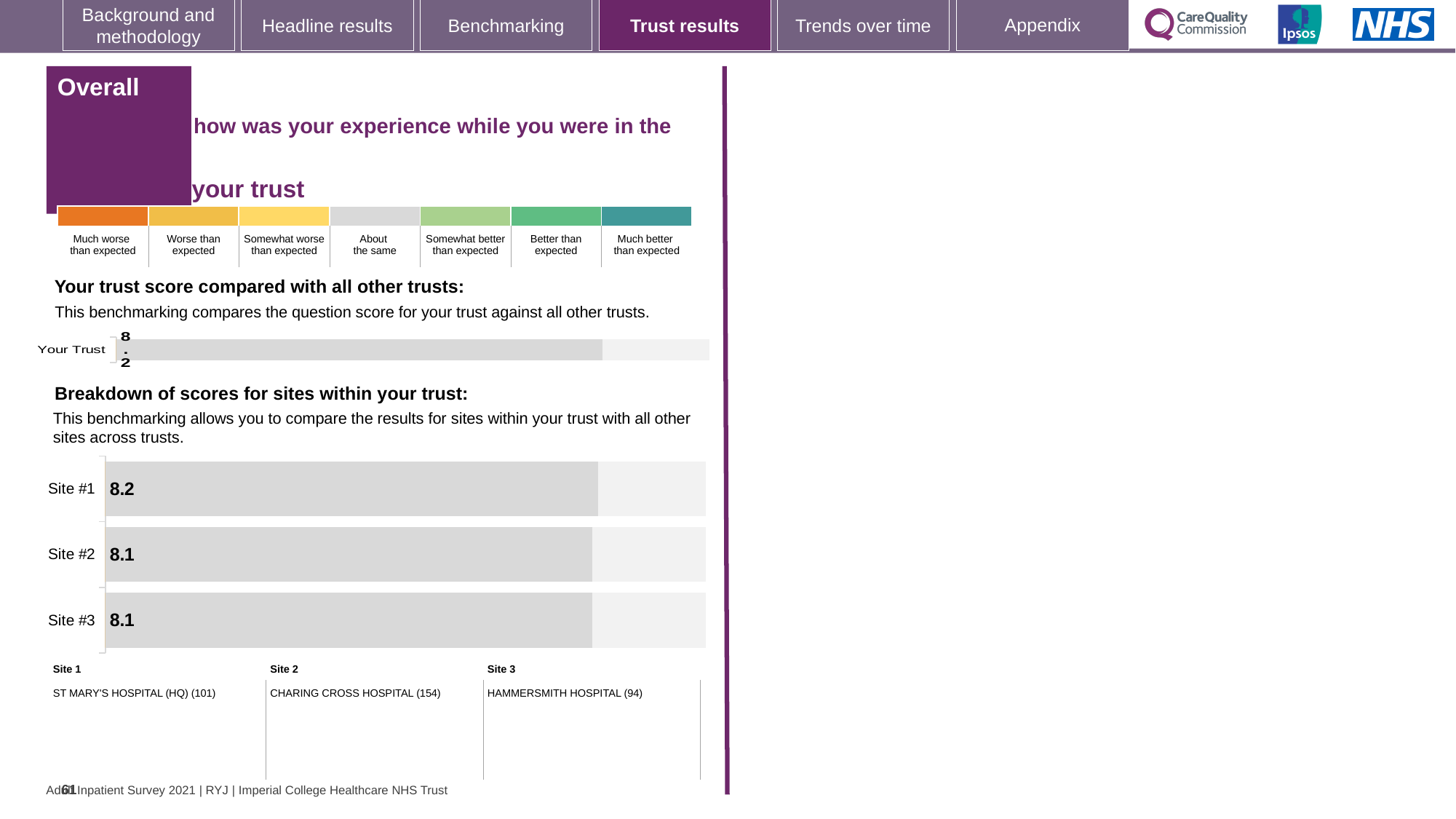
In the 'Breakdown of scores for sites within your trust' chart, what is the score for Site #3? 8.1 What kind of chart is the 'Breakdown of scores for sites within your trust' chart? Bar chart In the 'Breakdown of scores for sites within your trust' chart, are the scores for Site #2 and Site #3 equal? Yes In the 'Breakdown of scores for sites within your trust' chart, which site has the highest score? Site #1 In the 'Breakdown of scores for sites within your trust' chart, what is the difference between the scores for Site #1 and Site #2? 0.1 In the 'Breakdown of scores for sites within your trust' chart, which has the larger score, Site #1 or Site #3? Site #1 According to the site key below the chart, which hospital is Site 1? ST MARY'S HOSPITAL (HQ) (101) How many sites are shown in the 'Breakdown of scores for sites within your trust' chart? 3 In the 'Breakdown of scores for sites within your trust' chart, what is the score for Site #2? 8.1 How many bars are shown in the 'Your trust score compared with all other trusts' chart? 1 In the 'Breakdown of scores for sites within your trust' chart, what is the score for Site #1? 8.2 In the 'Your trust score compared with all other trusts' chart, what is the score for Your Trust? 8.2